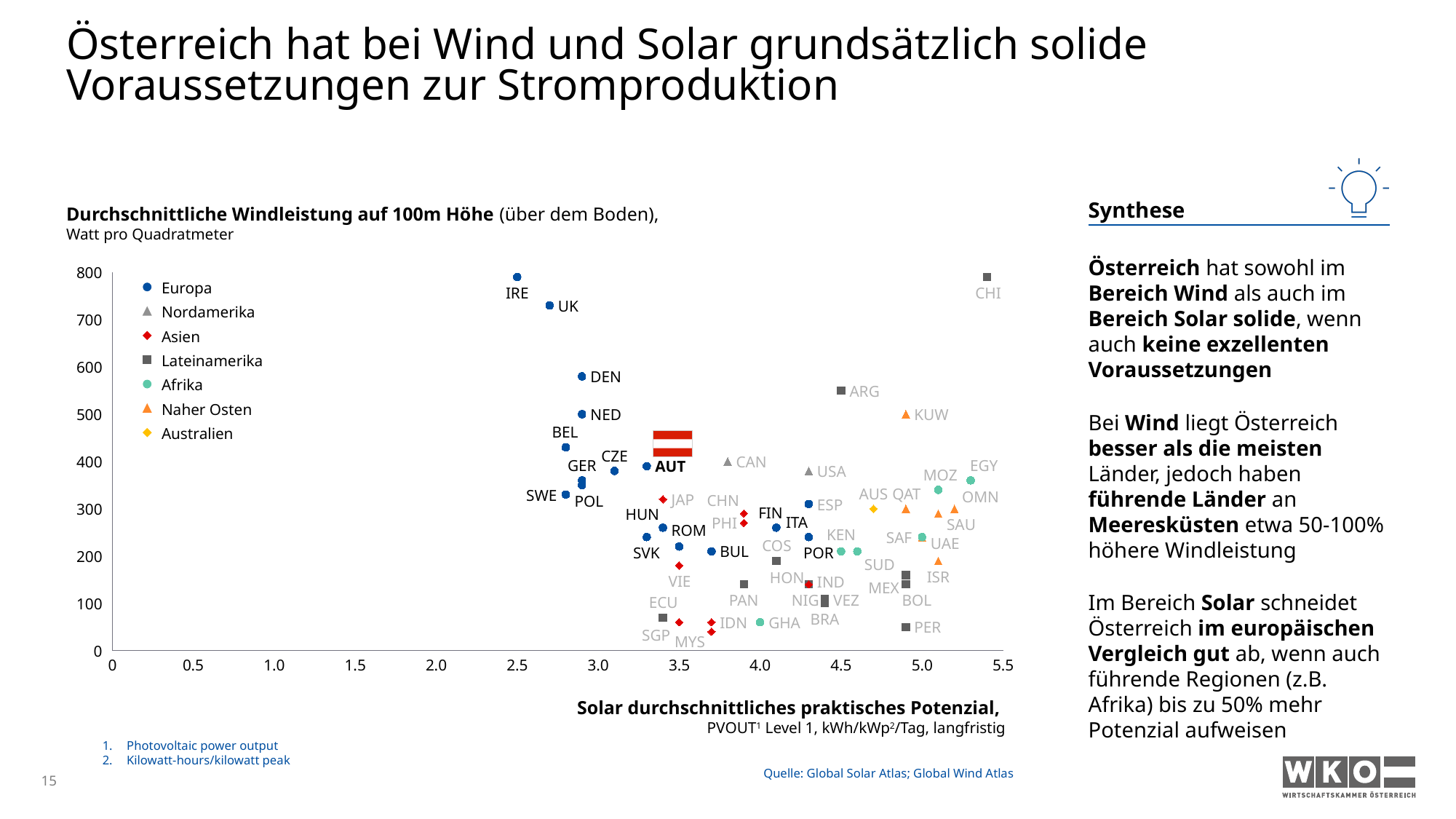
Is the wind value for IRE greater or less than 700? greater Is the solar value for CHI greater or less than 5.0? greater Is the wind value for POR greater or less than 300? less Which colour marks the Europa points in the legend? blue What kind of chart is shown on the slide? scatter chart How many regions does the legend list? 7 Which has the higher wind value, DEN or NED? DEN Which has the higher wind value, IRE or UK? IRE Which country has the lowest solar value on the chart? IRE